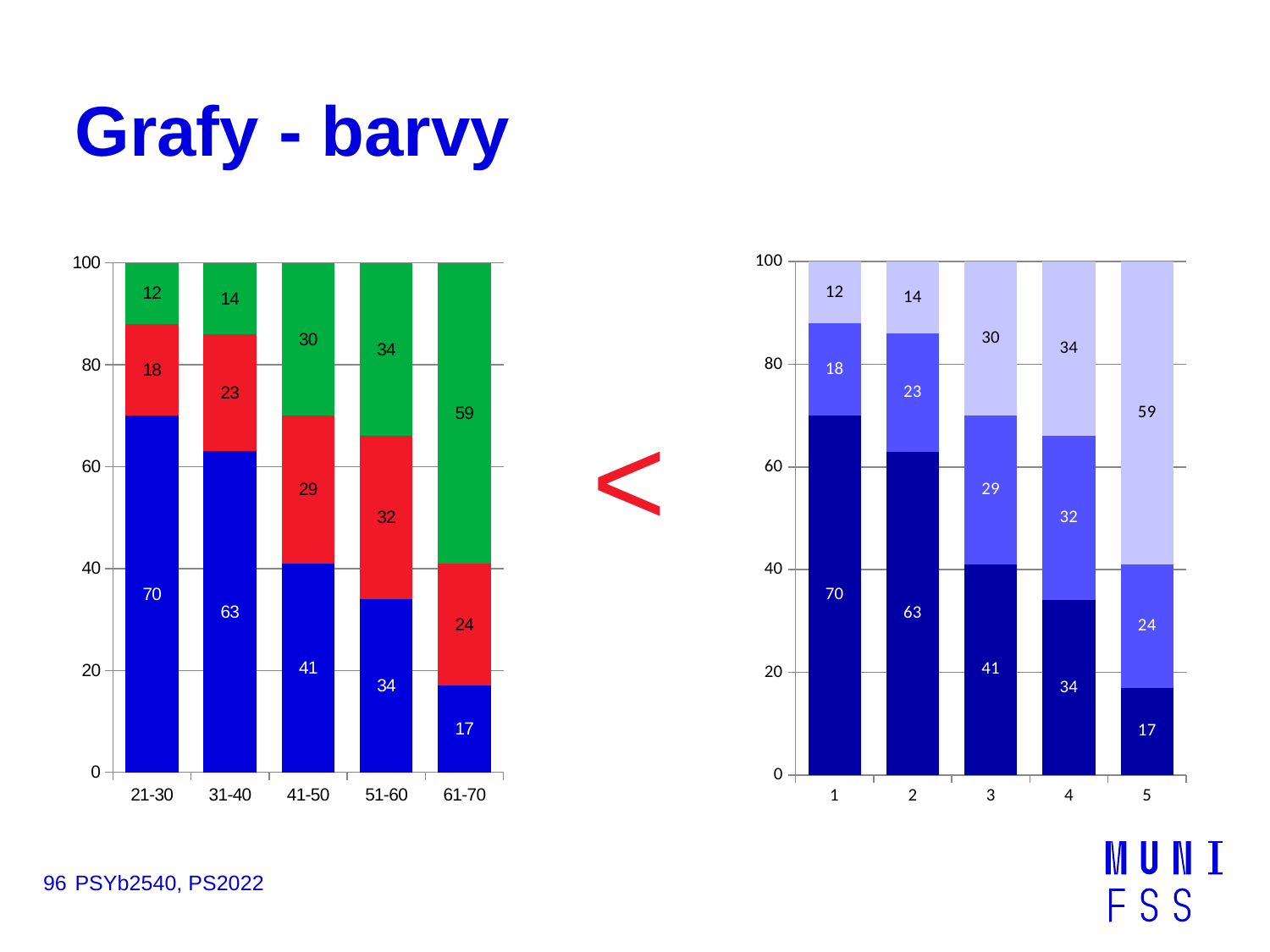
In the left chart, which category has the smallest green (top) segment? 21-30 In the left chart, which category has the largest blue (bottom) segment? 21-30 What is the title of the slide? Grafy - barvy In the left chart, what is the value of the green (top) segment for the 61-70 category? 59 In the left chart, what is the value of the blue (bottom) segment for the 21-30 category? 70 In the left chart, what is the total of the stacked bar for the 41-50 category? 100 What type of chart is shown on the right side of the slide? stacked bar chart In the left chart, what is the difference between the blue segment values for 21-30 and 61-70? 53 In the right chart, is the bottom segment for category 2 larger or smaller than the bottom segment for category 3? larger In the left chart, do the blue (bottom) segment values rise or fall from 21-30 to 61-70? fall How many categories are shown on the x axis of the left chart? 5 In the right chart, what is the value of the middle segment for category 4? 32